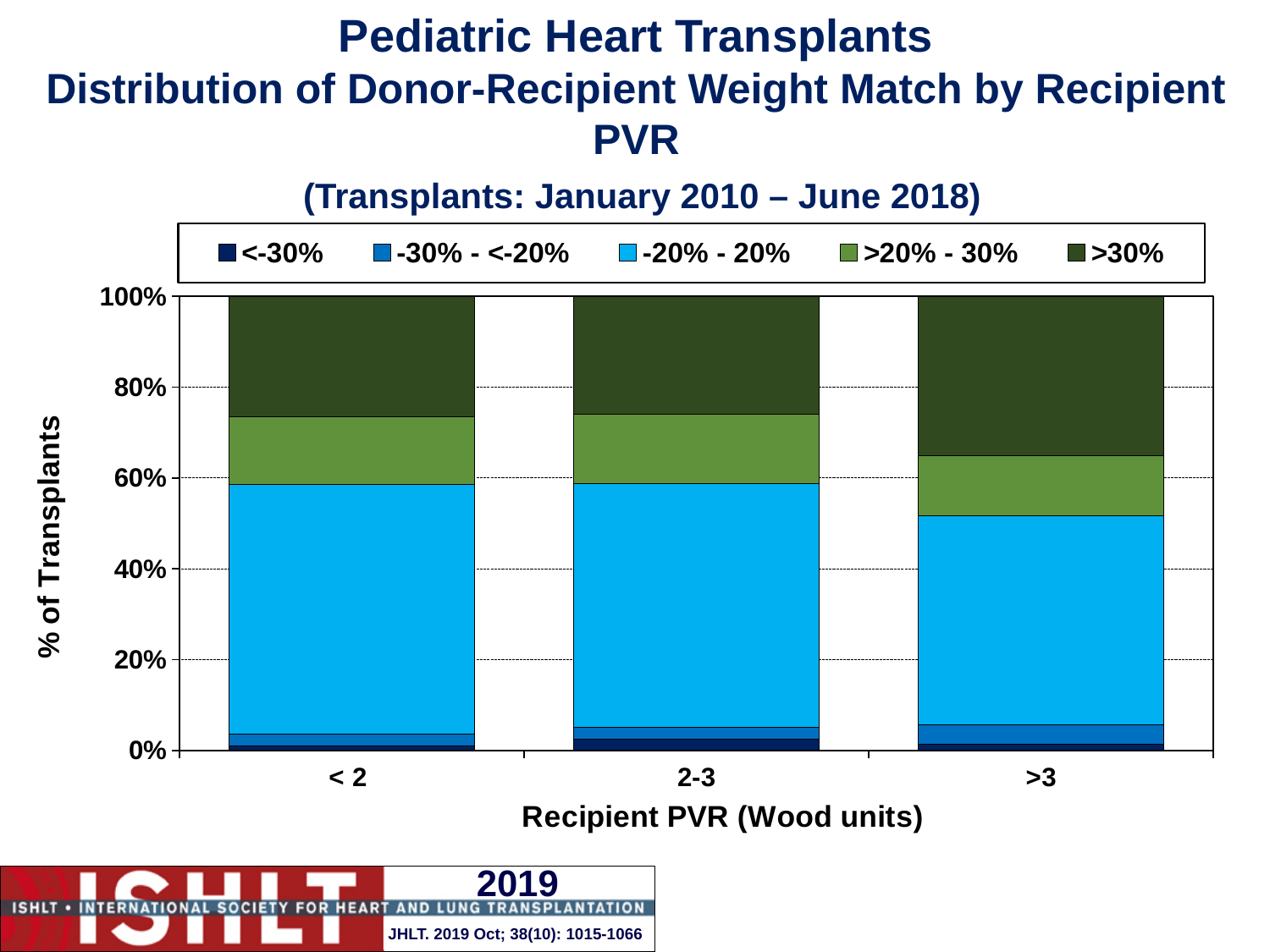
Is the >30% segment larger for the >3 category or the 2-3 category? >3 What kind of chart is shown on the slide? stacked bar chart Is the cumulative top of the >20% - 30% segment for the < 2 category greater or less than 80%? less How many recipient PVR categories are shown on the x axis? 3 Is the cumulative top of the >20% - 30% segment for the >3 category greater or less than 60%? greater What is the label of the y axis? % of Transplants Which recipient PVR category has the largest >30% segment? >3 Which recipient PVR category has the smallest -20% - 20% segment? >3 How many series does the legend list? 5 Is the cumulative top of the -20% - 20% segment for the >3 category greater or less than 60%? less What is the total height of the stacked bar for the < 2 category? 100% What is the label of the x axis? Recipient PVR (Wood units)